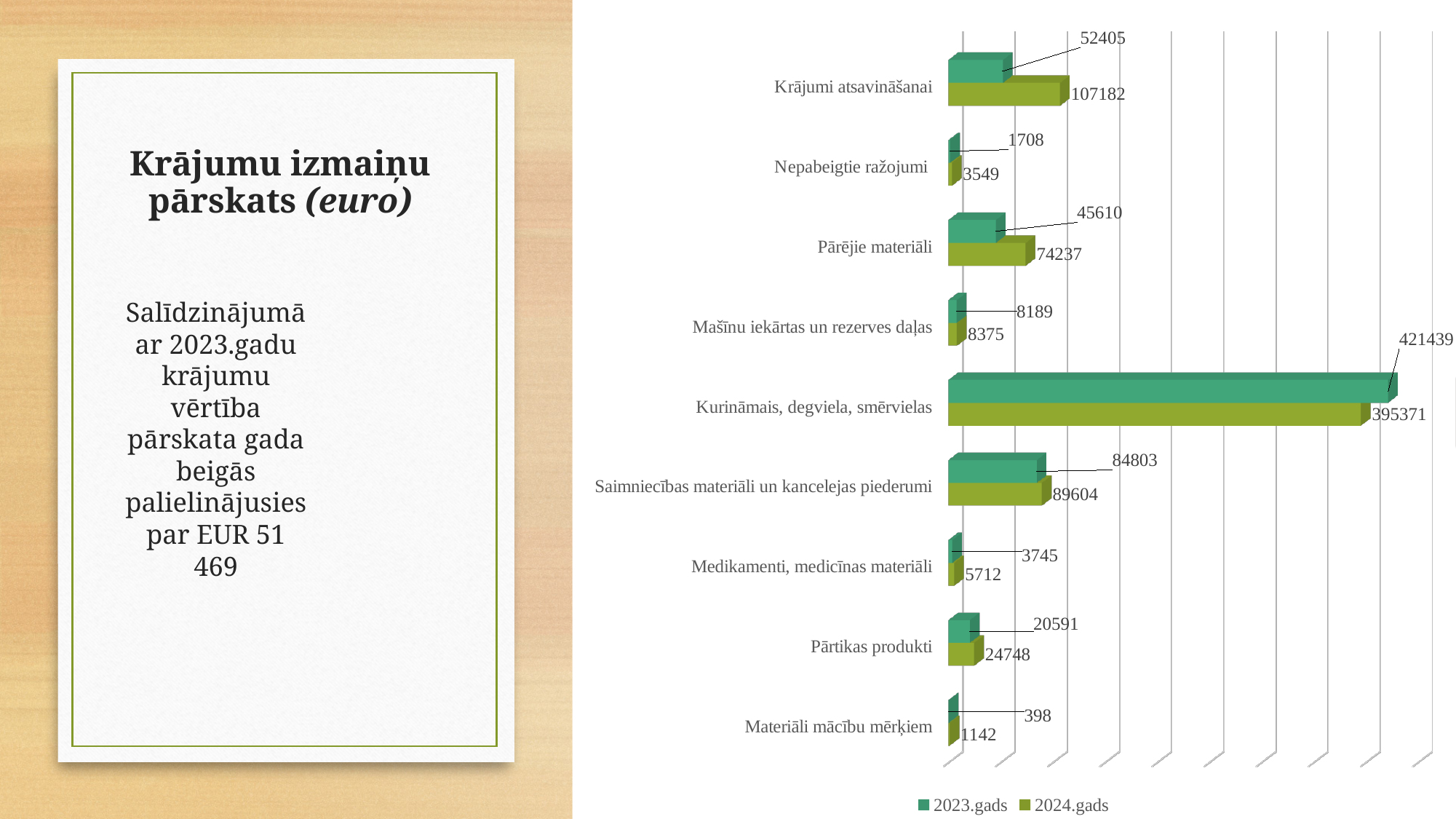
What are the two series named in the legend? 2023.gads and 2024.gads What kind of chart is shown on the slide? Bar chart How many categories are shown on the chart? 9 What is the 2024.gads value for Krājumi atsavināšanai? 107182 Which category has the lowest 2023.gads value? Materiāli mācību mērķiem What is the 2024.gads value for Pārtikas produkti? 24748 For Kurināmais, degviela, smērvielas, which series has the larger value, 2023.gads or 2024.gads? 2023.gads What is the difference between the 2024.gads and 2023.gads values for Krājumi atsavināšanai? 54777 Which category has the highest 2024.gads value? Kurināmais, degviela, smērvielas What is the 2023.gads value for Materiāli mācību mērķiem? 398 What is the 2023.gads value for Kurināmais, degviela, smērvielas? 421439 How many series does the legend list? 2